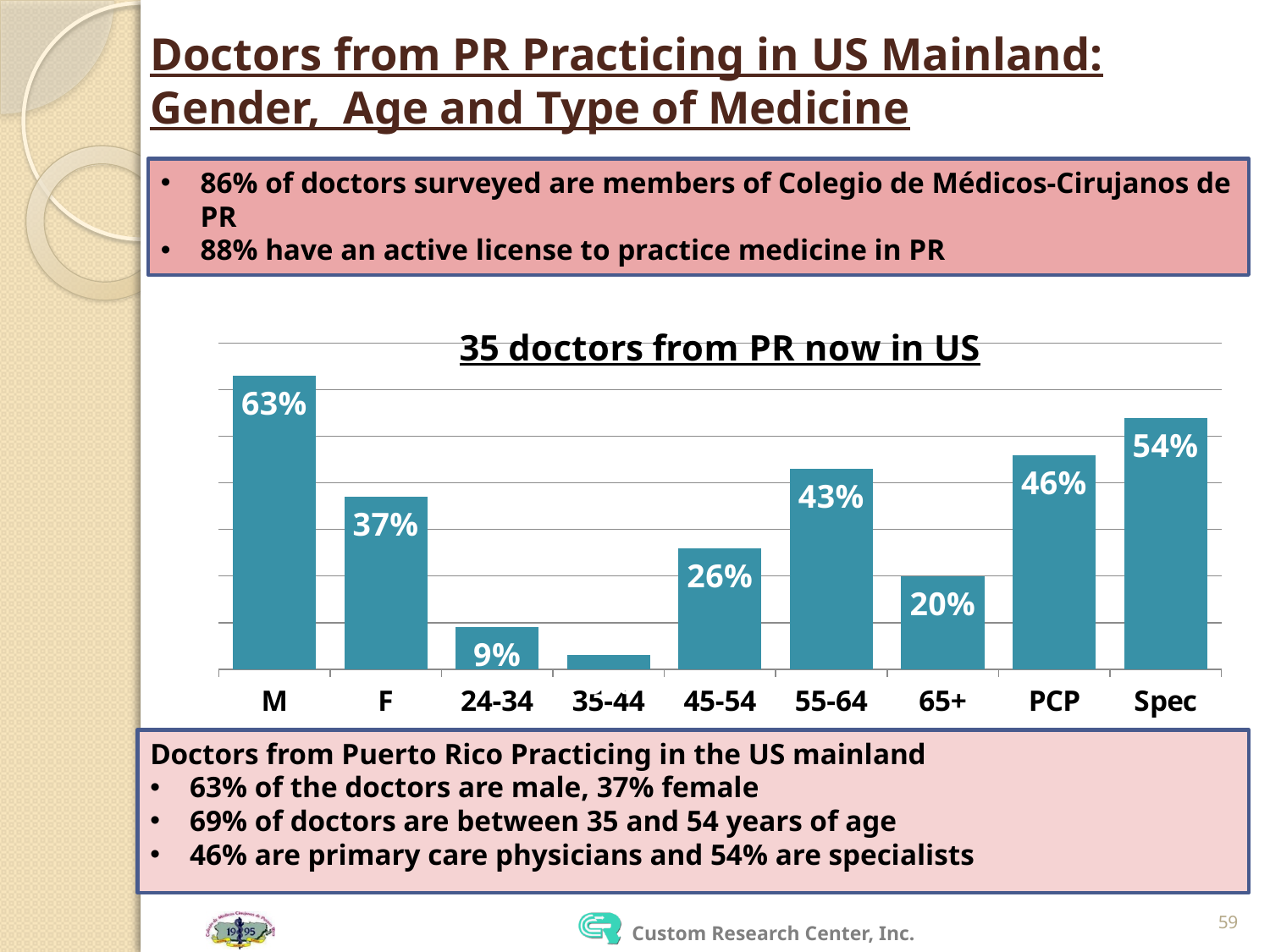
Which category has the lowest bar in the chart? 35-44 What is the value for the 24-34 age group? 9% Which category has the highest bar in the chart? M What type of chart is shown on the slide? Bar chart What is the value for the 55-64 age group in the chart? 43% What is the value for M in the chart '35 doctors from PR now in US'? 63% What percentage is shown for PCP in the chart? 46% Which is larger, the value for 45-54 or the value for 65+? 45-54 What is the title of the chart on the slide? 35 doctors from PR now in US How many categories are shown on the x axis of the chart? 9 What is the difference between the values for Spec and PCP? 8% What is the difference between the values for M and F? 26%